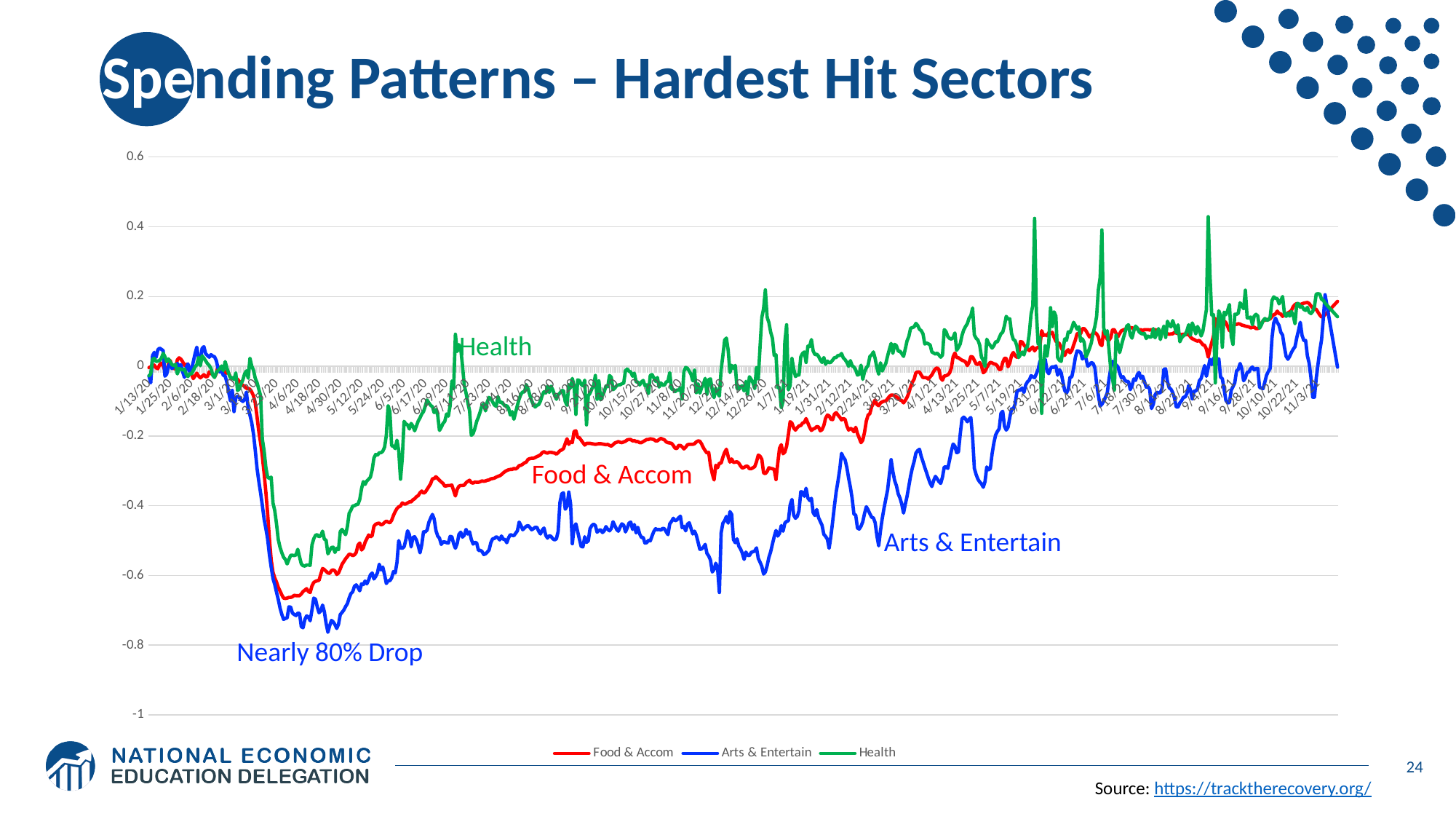
Around 10/15/20, which line is higher: Food & Accom or Arts & Entertain? Food & Accom Is the lowest point of the Food & Accom line greater or less than -0.4? less What annotation is written near the lowest point of the blue line? Nearly 80% Drop Which series fell the least during the spring 2020 drop? Health Which series are listed in the chart legend? Food & Accom, Arts & Entertain, Health Is the lowest point of the Arts & Entertain line greater or less than -0.6? less Which series reached the lowest value during the spring 2020 drop? Arts & Entertain Is the lowest point of the Health line greater or less than -0.8? greater From mid-2020 to late 2021, does the Arts & Entertain line generally rise or fall? Rise What kind of chart is shown on the slide? Line chart How many series does the legend list? 3 What colour is the Health line? Green